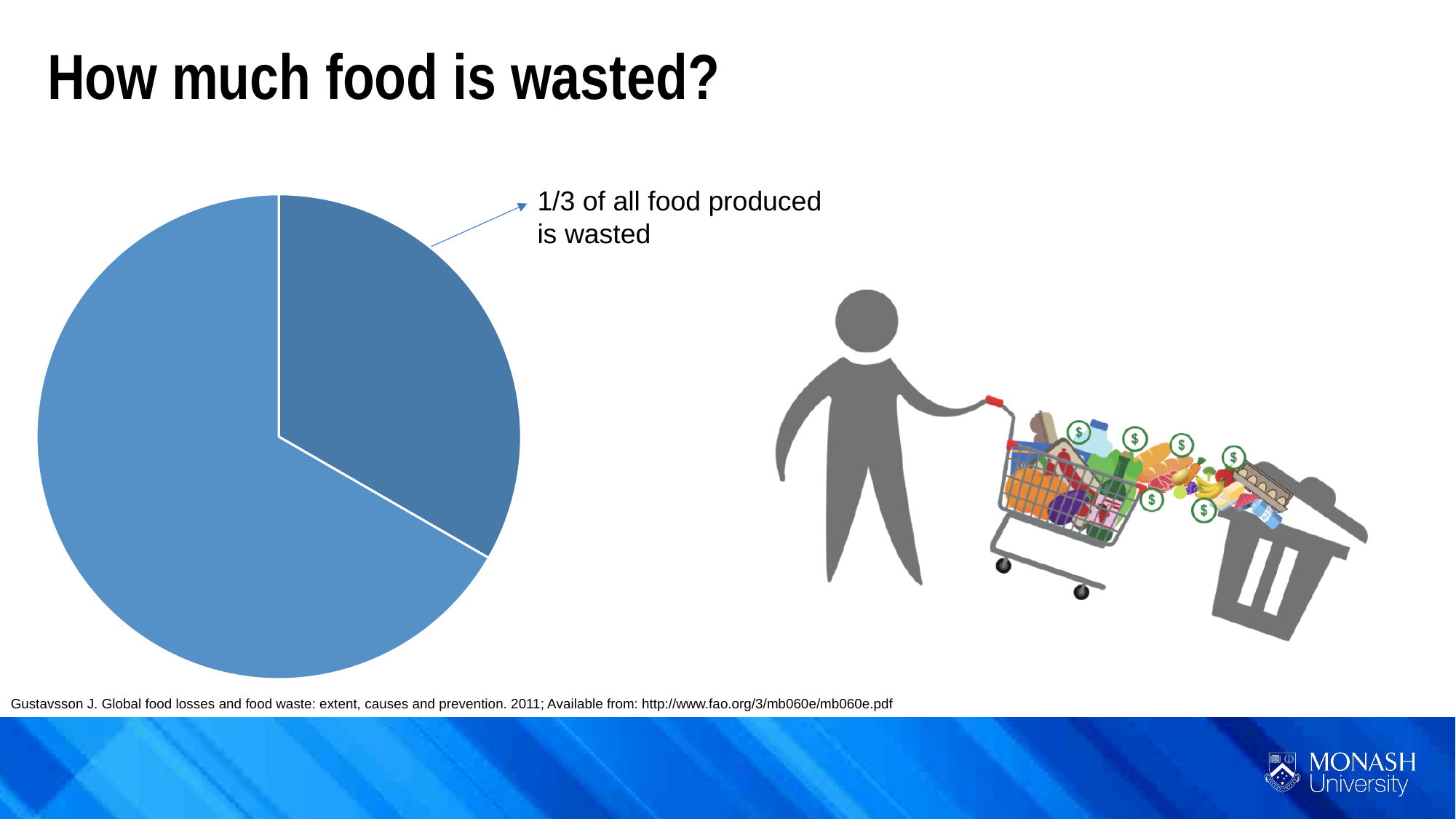
Which slice of the pie chart is larger: the annotated slice (wasted food) or the unannotated slice? the unannotated slice What kind of chart is shown on the slide? pie chart What is the title of the slide containing the pie chart? How much food is wasted? According to the annotation on the pie chart, what share of all food produced is wasted? 1/3 Is the slice annotated as wasted food larger or smaller than the other slice of the pie? smaller Is the share of the pie representing wasted food greater or less than 50%? less How many slices does the pie chart have? 2 What does the annotation pointing to the smaller slice of the pie chart say? 1/3 of all food produced is wasted